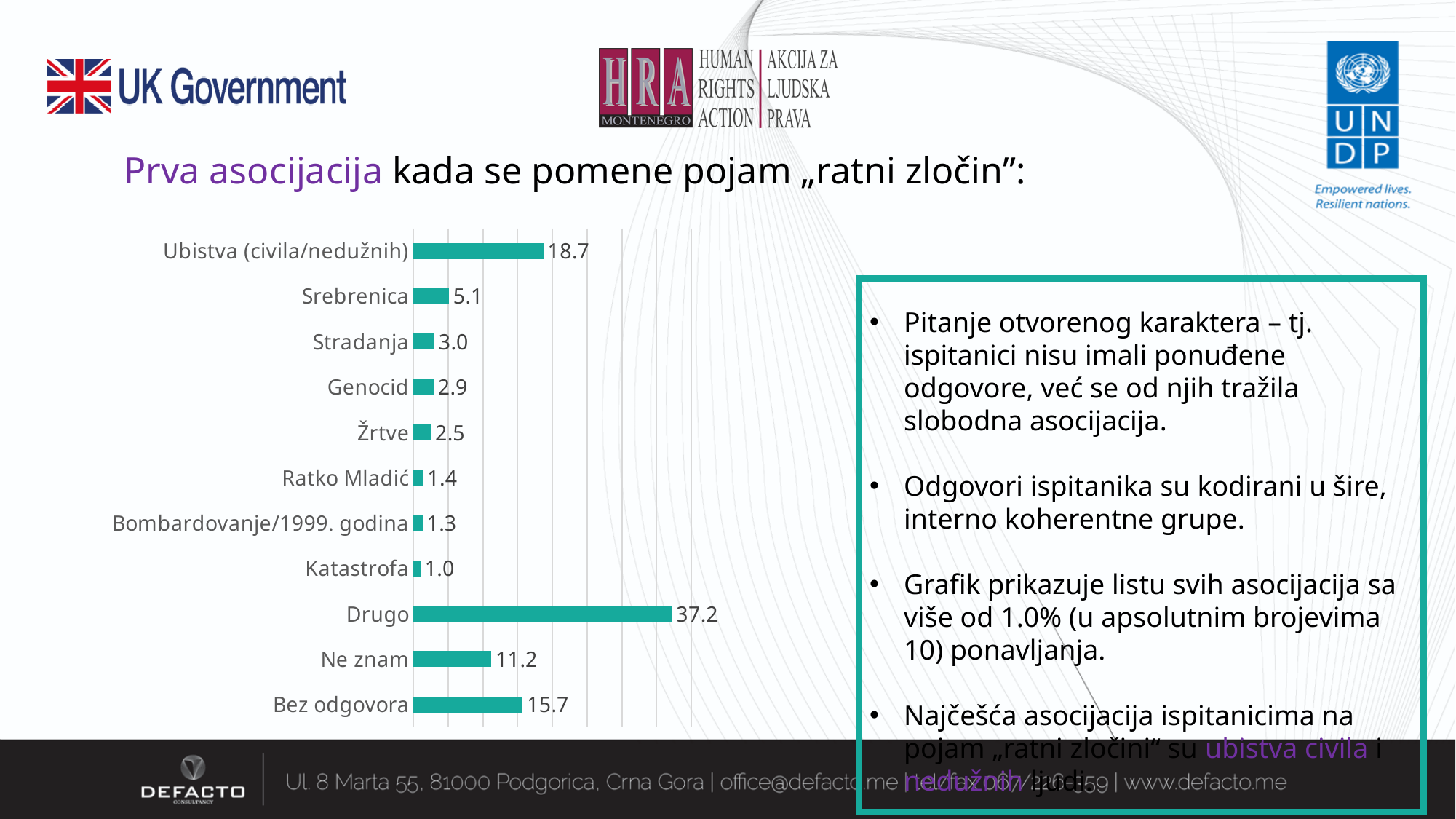
What is the value for Ne znam? 11.2 What is the difference between the values for Bez odgovora and Ne znam? 4.5 What is the value for Žrtve? 2.5 What kind of chart is shown on the slide? Bar chart How many categories are shown in the chart? 11 Which is larger, the value for Stradanja or the value for Genocid? Stradanja What is the value for Bombardovanje/1999. godina? 1.3 What is the difference between the values for Drugo and Ubistva (civila/nedužnih)? 18.5 Which category has the highest value? Drugo Which category has the lowest value? Katastrofa What is the value for Srebrenica? 5.1 What is the value for Ubistva (civila/nedužnih)? 18.7